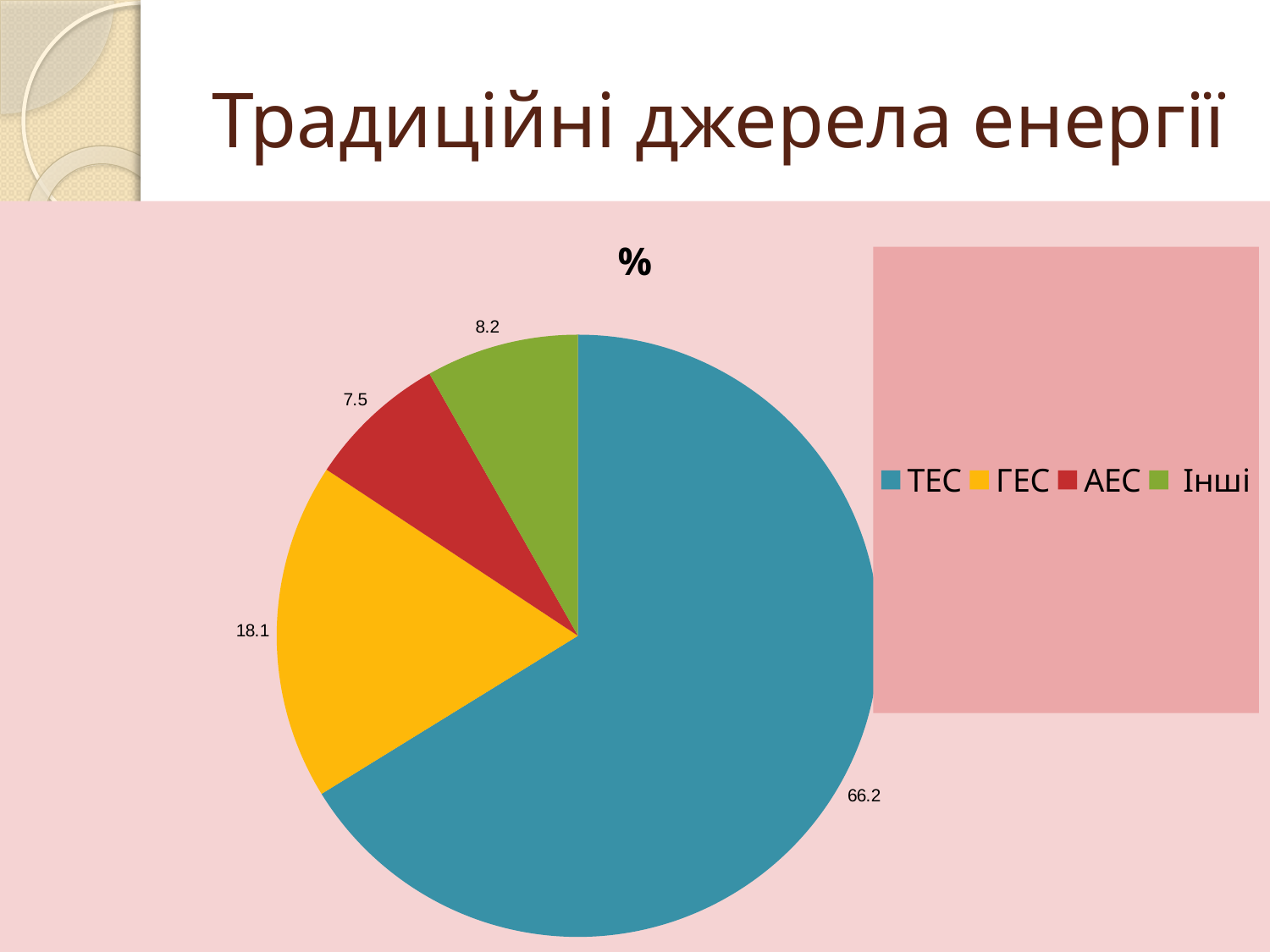
What is the value for ТЕС in the pie chart? 66.2 Which is larger, the value for Інші or the value for АЕС? Інші What is the title of the chart? % What is the difference between the values for ТЕС and ГЕС? 48.1 What is the value for ГЕС in the pie chart? 18.1 What kind of chart is shown on the slide? Pie chart How many categories are shown in the pie chart? 4 What is the value for АЕС in the pie chart? 7.5 Which category has the smallest slice of the pie chart? АЕС What is the value for Інші in the pie chart? 8.2 What is the difference between the values for Інші and АЕС? 0.7 Which category has the largest slice of the pie chart? ТЕС